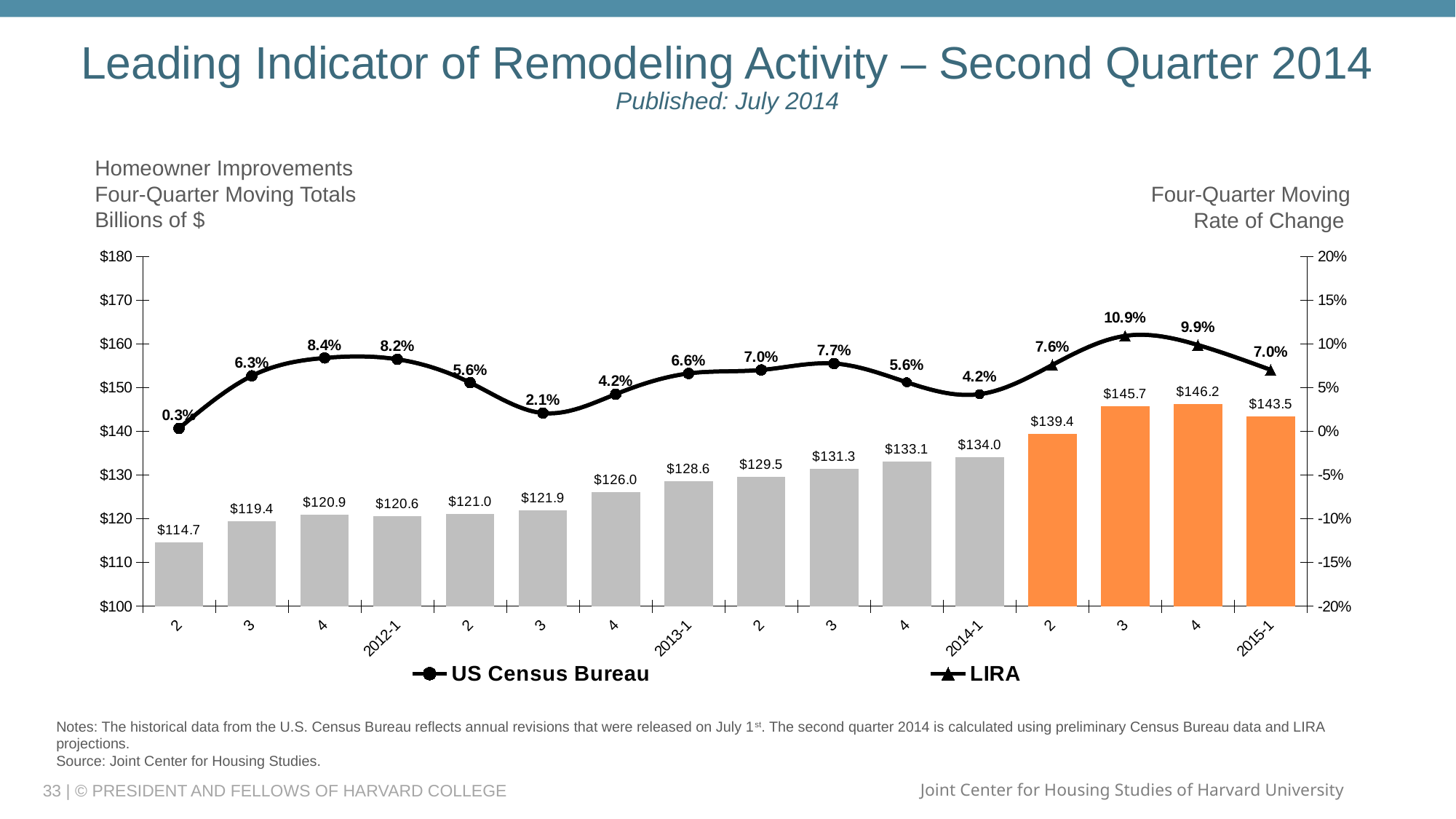
Which quarter has the highest four-quarter moving total? 2014-4 ($146.2) What is the four-quarter moving rate of change shown for 2013-1? 6.6% What are the two series named in the legend? US Census Bureau and LIRA What is the highest four-quarter moving rate of change shown on the chart? 10.9% What kind of chart is this? Combination bar and line chart What is the lowest four-quarter moving total shown on the chart? $114.7 How many quarters (bars) are plotted on the chart? 16 Which is larger, the rate of change for 2012-1 or for 2013-3? 2012-1 (8.2%) What is the four-quarter moving total for 2014-1? $134.0 What is the four-quarter moving total projected for 2015-1? $143.5 How many series does the legend list? 2 What is the difference between the four-quarter moving totals for 2014-3 and 2014-2? $6.3